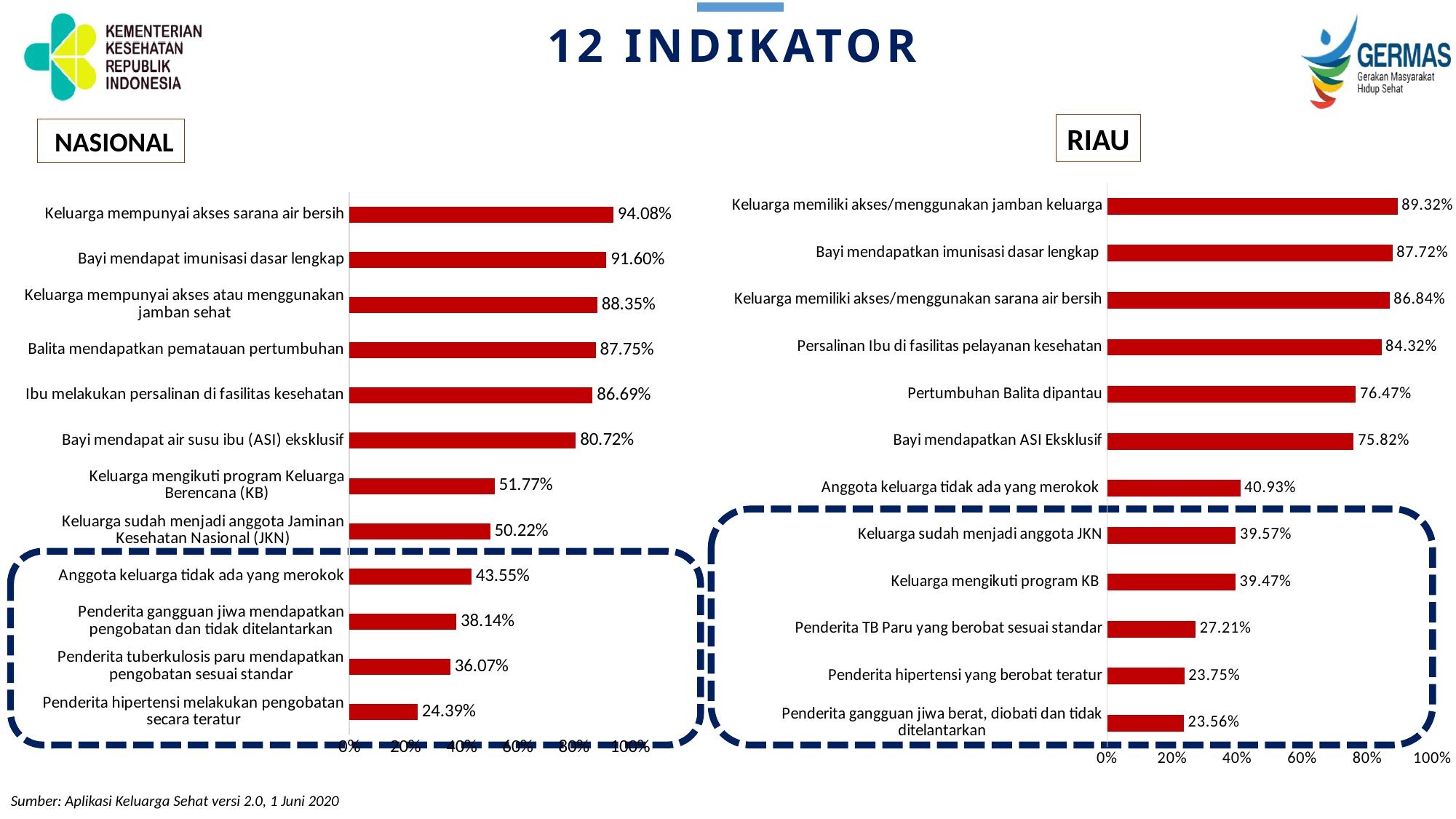
In the RIAU chart, what is the value for 'Anggota keluarga tidak ada yang merokok'? 40.93% What type of chart is the NASIONAL chart? Bar chart In the NASIONAL chart, which indicator has the lowest value? Penderita hipertensi melakukan pengobatan secara teratur In the RIAU chart, what is the value for 'Penderita gangguan jiwa berat, diobati dan tidak ditelantarkan'? 23.56% What is the source cited at the bottom of the slide? Aplikasi Keluarga Sehat versi 2.0, 1 Juni 2020 In the NASIONAL chart, what is the value for 'Penderita tuberkulosis paru mendapatkan pengobatan sesuai standar'? 36.07% In the NASIONAL chart, what is the value for 'Keluarga mempunyai akses sarana air bersih'? 94.08% In the RIAU chart, what is the difference between 'Bayi mendapatkan imunisasi dasar lengkap' and 'Bayi mendapatkan ASI Eksklusif'? 11.90% In the RIAU chart, which indicator has the highest value? Keluarga memiliki akses/menggunakan jamban keluarga In the NASIONAL chart, what is the difference between 'Bayi mendapat imunisasi dasar lengkap' and 'Bayi mendapat air susu ibu (ASI) eksklusif'? 10.88% In the NASIONAL chart, which is larger: 'Keluarga mengikuti program Keluarga Berencana (KB)' or 'Anggota keluarga tidak ada yang merokok'? Keluarga mengikuti program Keluarga Berencana (KB) How many indicators are plotted in the RIAU chart? 12